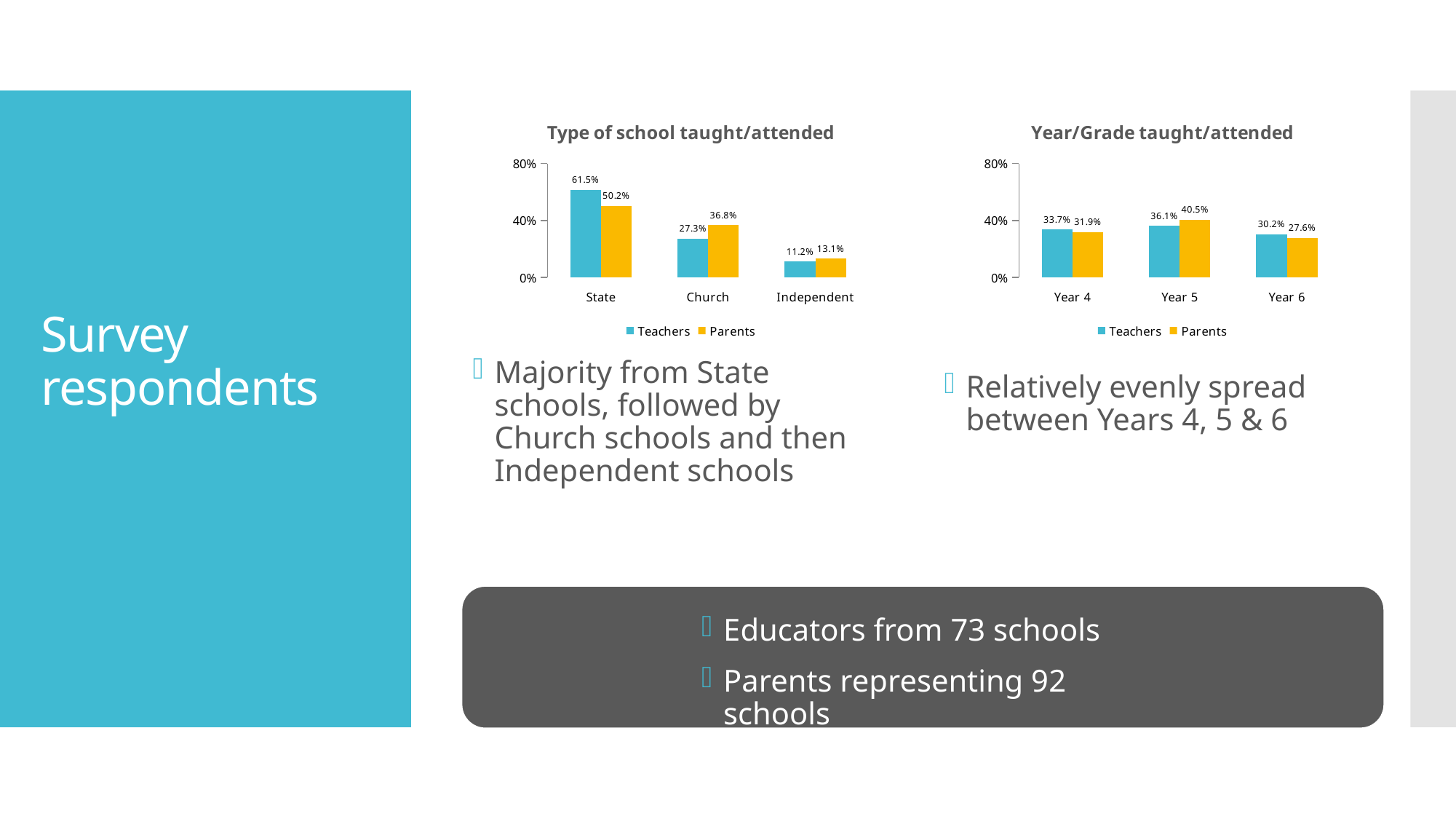
In the 'Type of school taught/attended' chart, how many series does the legend list? 2 In the 'Year/Grade taught/attended' chart, which year has the highest value for Parents? Year 5 In the 'Year/Grade taught/attended' chart, how many year categories are shown on the x axis? 3 What kind of chart is the 'Year/Grade taught/attended' chart? Bar chart In the 'Type of school taught/attended' chart, what is the difference between Teachers and Parents at State schools? 11.3% In the 'Year/Grade taught/attended' chart, which is larger for Year 4: Teachers or Parents? Teachers In the 'Type of school taught/attended' chart, which category has the lowest value for Teachers? Independent In the 'Type of school taught/attended' chart, what is the value for Teachers at State schools? 61.5% In the 'Year/Grade taught/attended' chart, what is the value for Teachers in Year 6? 30.2% In the 'Type of school taught/attended' chart, what is the value for Parents at Church schools? 36.8% In the 'Type of school taught/attended' chart, is the Parents value for Independent schools greater or less than 40%? less In the 'Year/Grade taught/attended' chart, what is the value for Parents in Year 5? 40.5%